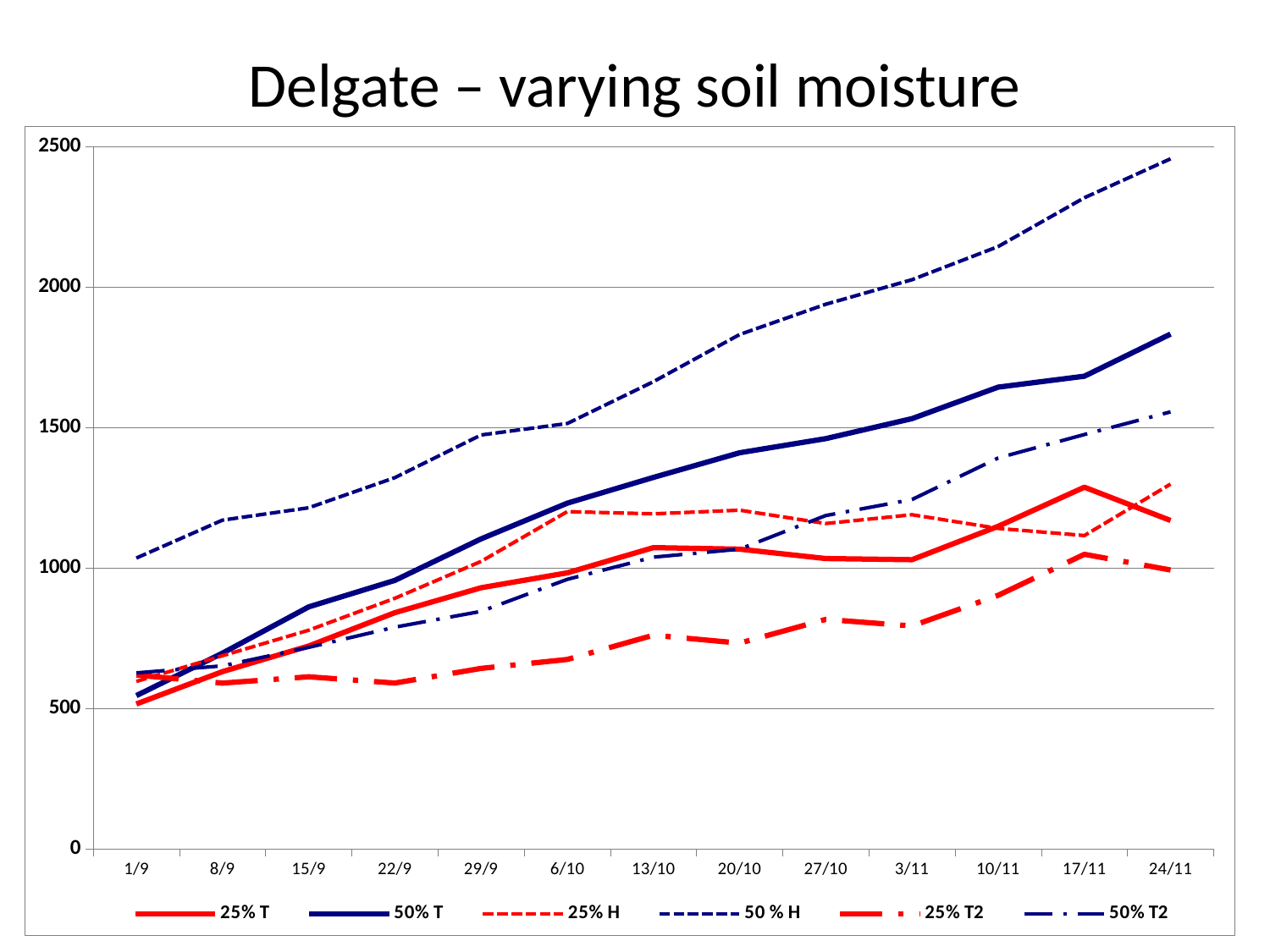
How many series does the legend list? 6 What kind of chart is shown on the slide? line chart Which series is highest at 24/11? 50 % H Which series is highest at 1/9? 50 % H Is the value for 25% T2 at 22/9 greater or less than 500? greater Does the 50 % H series rise or fall from 1/9 to 24/11? rise Is the value for 50% T at 24/11 greater or less than 1500? greater What is the title of the slide? Delgate – varying soil moisture At 24/11, which is higher: 50% T or 50% T2? 50% T How many dates are shown along the x axis? 13 Which series is lowest at 24/11? 25% T2 Is the value for 50 % H at 24/11 greater or less than 2000? greater